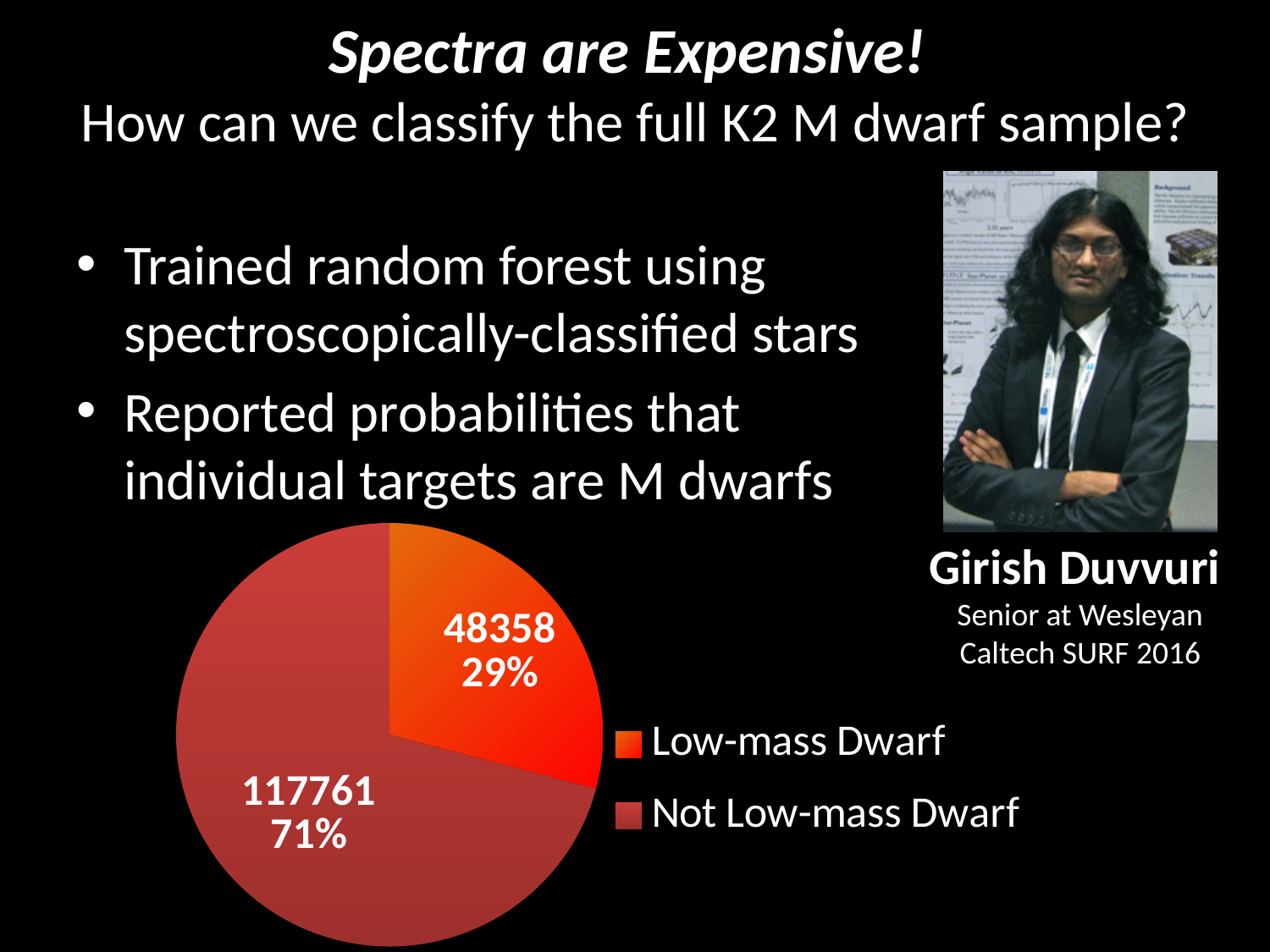
Which category has the largest slice of the pie? Not Low-mass Dwarf What is the total of the two counts shown in the pie chart? 166119 How many slices does the pie chart have? 2 What percentage share of the pie is Low-mass Dwarf? 29% Which category has the smallest slice of the pie? Low-mass Dwarf What percentage share of the pie is Not Low-mass Dwarf? 71% How many entries does the legend of the pie chart list? 2 Which is larger, the count for Low-mass Dwarf or for Not Low-mass Dwarf? Not Low-mass Dwarf What is the count for Low-mass Dwarf in the pie chart? 48358 What kind of chart is shown on the slide? pie chart What is the count for Not Low-mass Dwarf in the pie chart? 117761 What is the difference between the Not Low-mass Dwarf count and the Low-mass Dwarf count? 69403